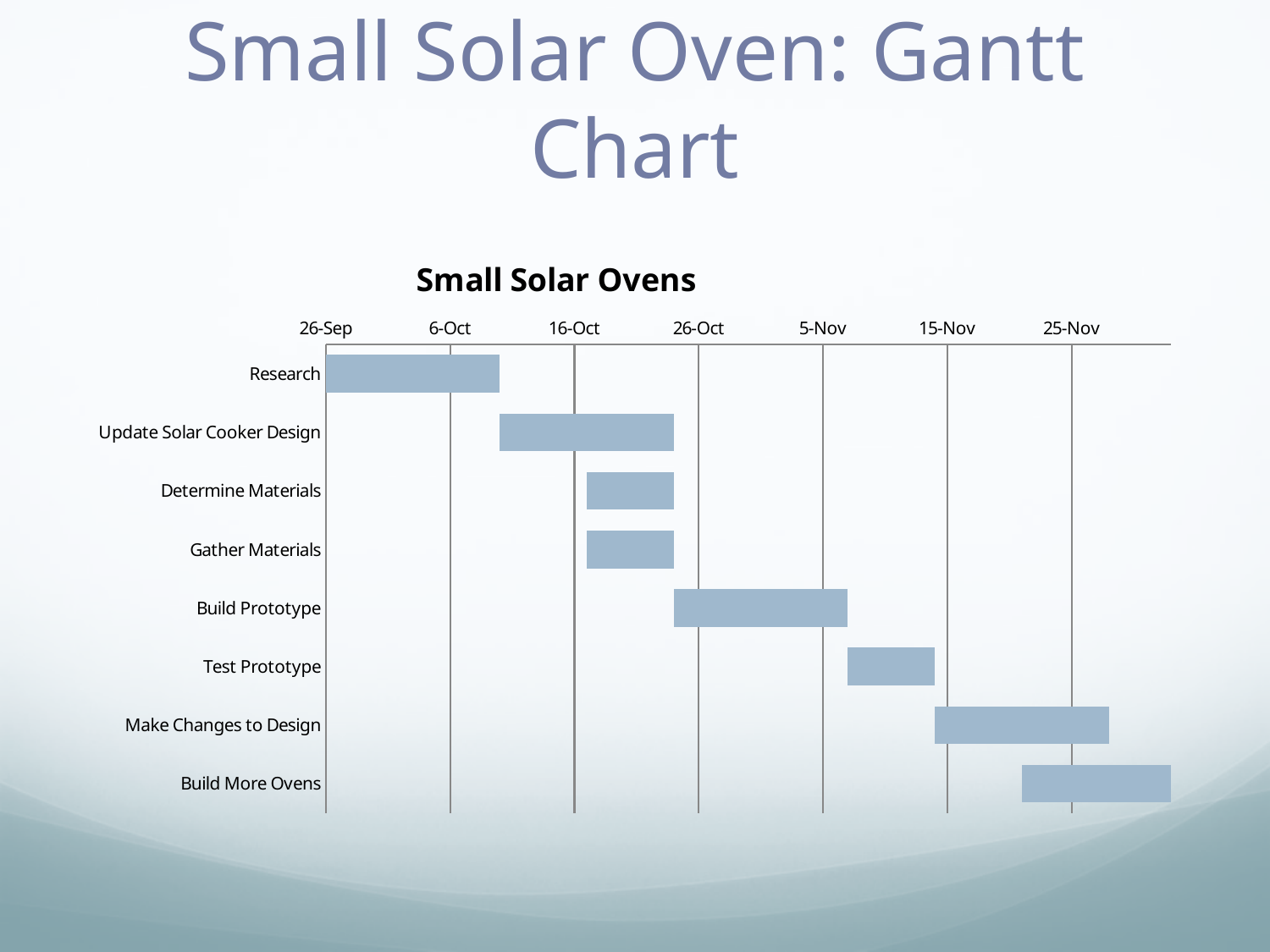
Does the Research task end before or after 6-Oct? after What is the title of the chart? Small Solar Ovens Which task starts earlier, Determine Materials or Build Prototype? Determine Materials Does the Update Solar Cooker Design task start before or after 16-Oct? before Which task starts earliest in the schedule? Research How many tasks are listed on the vertical axis of the chart? 8 On what date does the Research task start? 26-Sep Which task finishes last in the schedule? Build More Ovens What kind of chart is shown on the slide? Bar chart (Gantt chart)